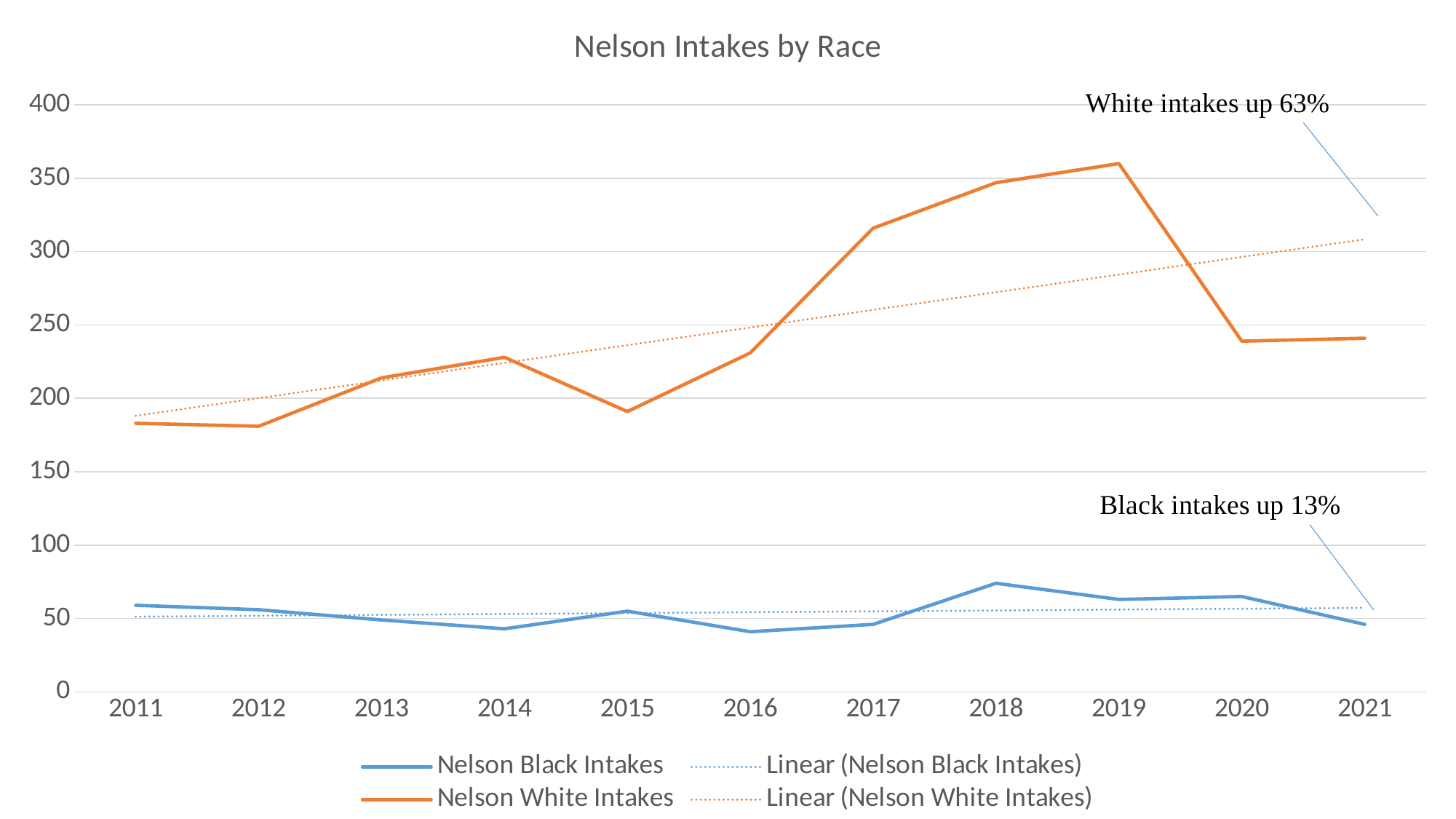
How many years are shown on the x axis? 11 Is the value for Nelson White Intakes in 2015 greater or less than 200? less What kind of chart is shown on the slide? line chart Which is larger: Nelson White Intakes in 2019 or in 2020? 2019 Is the value for Nelson White Intakes in 2019 greater or less than 350? greater In which year are Nelson Black Intakes highest? 2018 How many entries does the legend list? 4 In which year are Nelson White Intakes highest? 2019 Is the value for Nelson Black Intakes in 2016 greater or less than 50? less According to the annotation on the chart, by what percentage are White intakes up? 63% What is the title of the chart? Nelson Intakes by Race Do Nelson White Intakes rise or fall from 2016 to 2019? rise